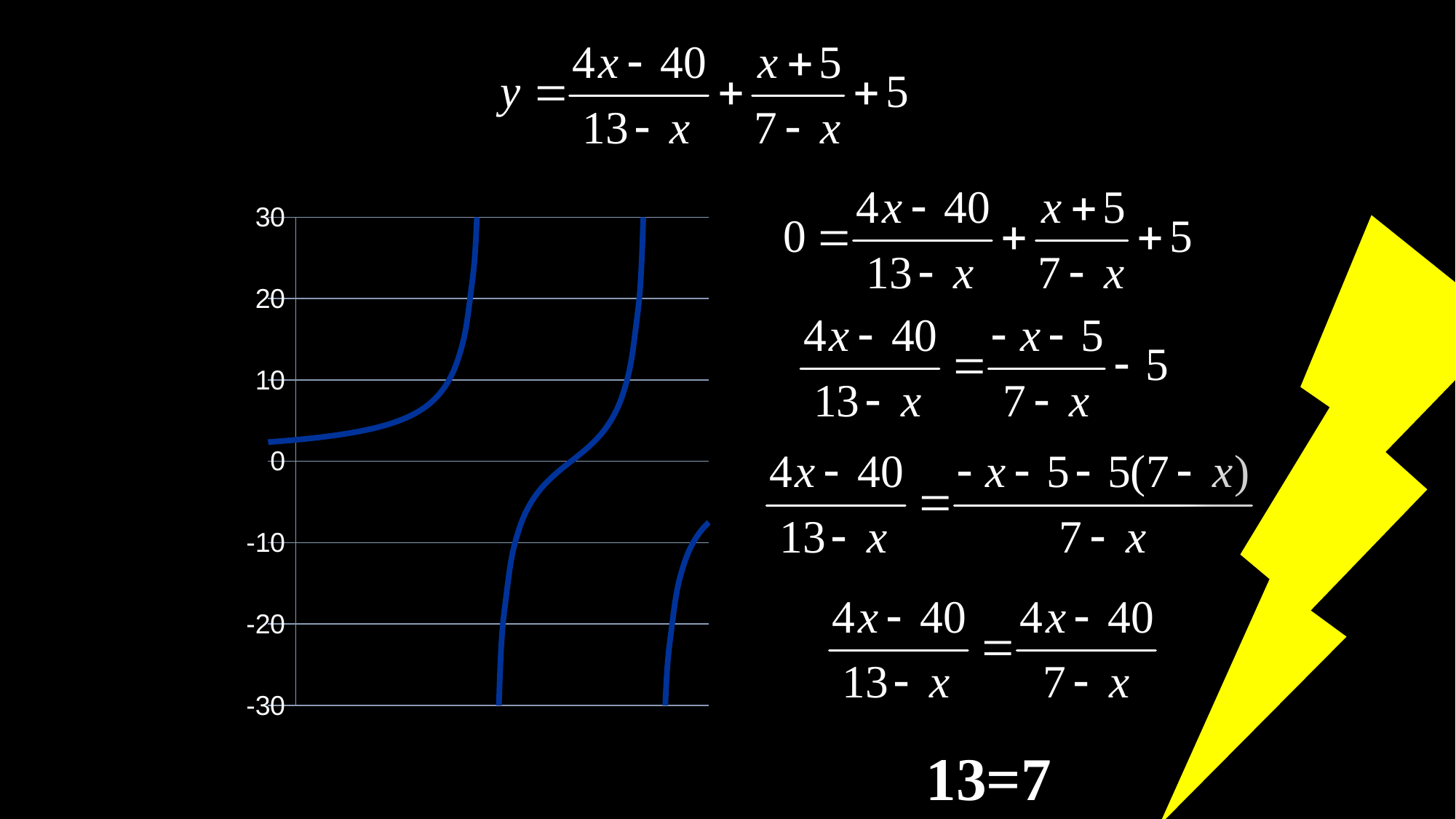
How many labelled tick values are there on the y axis of the chart? 7 How many separate branches of the curve are drawn on the chart? 3 Is the value of the curve at the right edge of the chart greater or less than 0? less Along the middle branch of the curve, does the value rise or fall moving from left to right? rise What is the lowest value labelled on the y axis of the chart? -30 Is the value of the curve at the left edge of the chart greater or less than 10? less Along the leftmost branch of the curve, does the value rise or fall moving from left to right? rise What kind of chart is shown on the slide? line chart Is the value of the curve at the left edge of the chart greater or less than 0? greater What is the highest value labelled on the y axis of the chart? 30